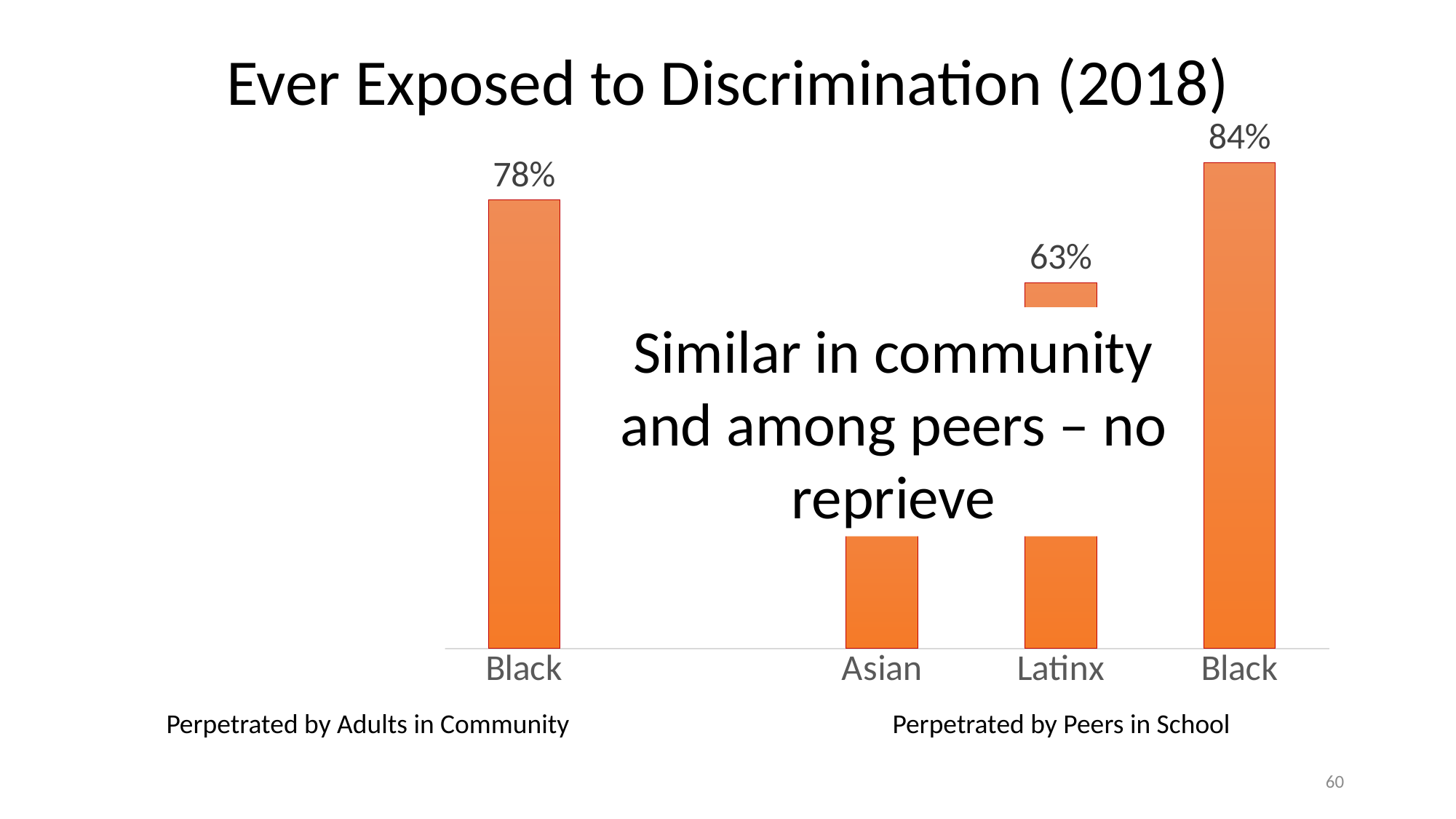
What kind of chart is shown on the slide? Bar chart Which bar has the highest value on the chart? Black (Perpetrated by Peers in School) How many bars are plotted on the chart? 4 What is the value for Black under 'Perpetrated by Peers in School'? 84% What text is overlaid in the middle of the chart? Similar in community and among peers – no reprieve What is the difference between the Black and Latinx values under 'Perpetrated by Peers in School'? 21 percentage points What is the value for Black under 'Perpetrated by Adults in Community'? 78% What is the title of the slide? Ever Exposed to Discrimination (2018) Under 'Perpetrated by Peers in School', which is larger: the Latinx value or the Black value? Black What is the value for Latinx under 'Perpetrated by Peers in School'? 63% Which is larger: the Black value for Adults in Community or the Black value for Peers in School? Black for Peers in School What is the difference between the Black value for Peers in School and the Black value for Adults in Community? 6 percentage points